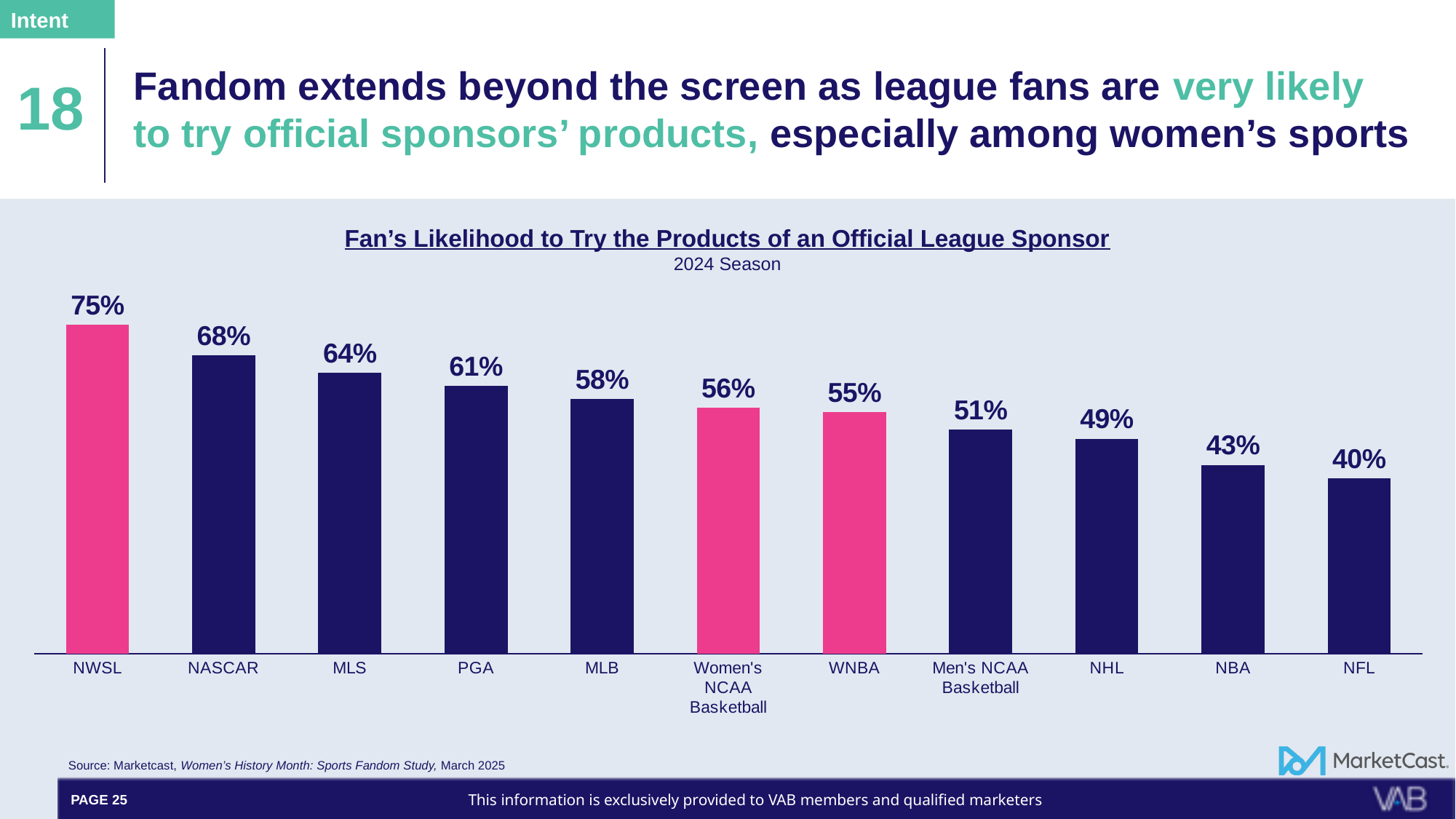
What is the value for Women's NCAA Basketball? 56% What is the value for NHL? 49% Which is larger, the value for WNBA or the value for Men's NCAA Basketball? WNBA What is the value for NWSL? 75% How many leagues are shown on the chart? 11 What kind of chart is shown on the slide? Bar chart Which season does the chart cover, according to its subtitle? 2024 Season Do the values rise or fall from left to right across the chart? Fall Which league has the lowest value on the chart? NFL Which league has the highest likelihood to try the products of an official league sponsor? NWSL What is the difference between the values for NASCAR and MLS? 4% What is the difference between the values for NWSL and NFL? 35%